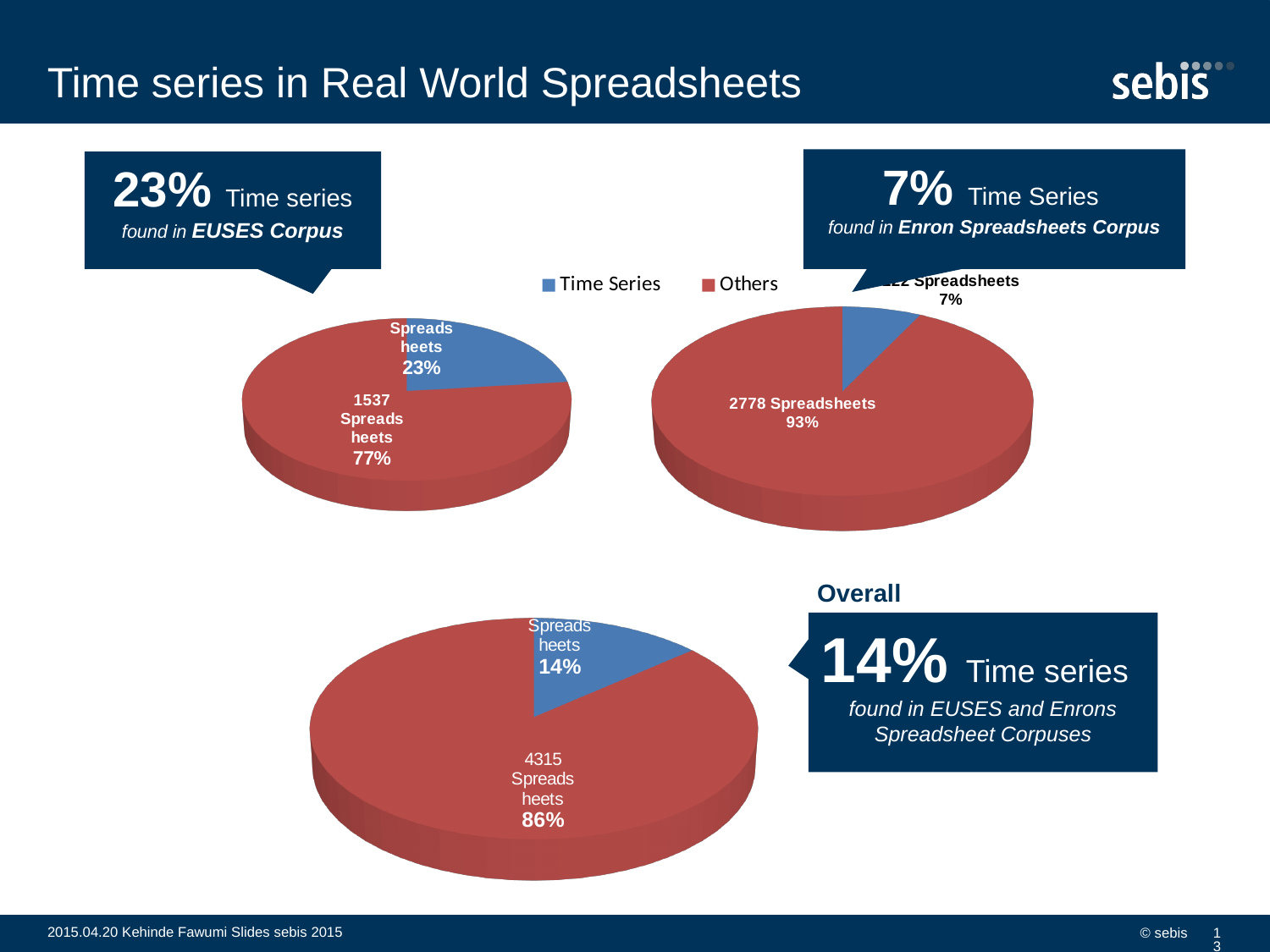
In the bottom pie chart (Overall), how many spreadsheets are in the Others slice? 4315 Spreadsheets In the top-left pie chart (EUSES Corpus), what share of spreadsheets is labelled as Time Series? 23% Which colour represents Time Series in the legend? Blue In the bottom pie chart (Overall), what share of spreadsheets is labelled as Others? 86% How many series does the legend list? 2 In the top-right pie chart (Enron Spreadsheets Corpus), what share of spreadsheets is labelled as Others? 93% What kind of chart is used on this slide? Pie chart In the top-right pie chart (Enron Spreadsheets Corpus), how many spreadsheets are in the Others slice? 2778 Spreadsheets In the top-left pie chart (EUSES Corpus), how many spreadsheets are in the Others slice? 1537 Spreadsheets